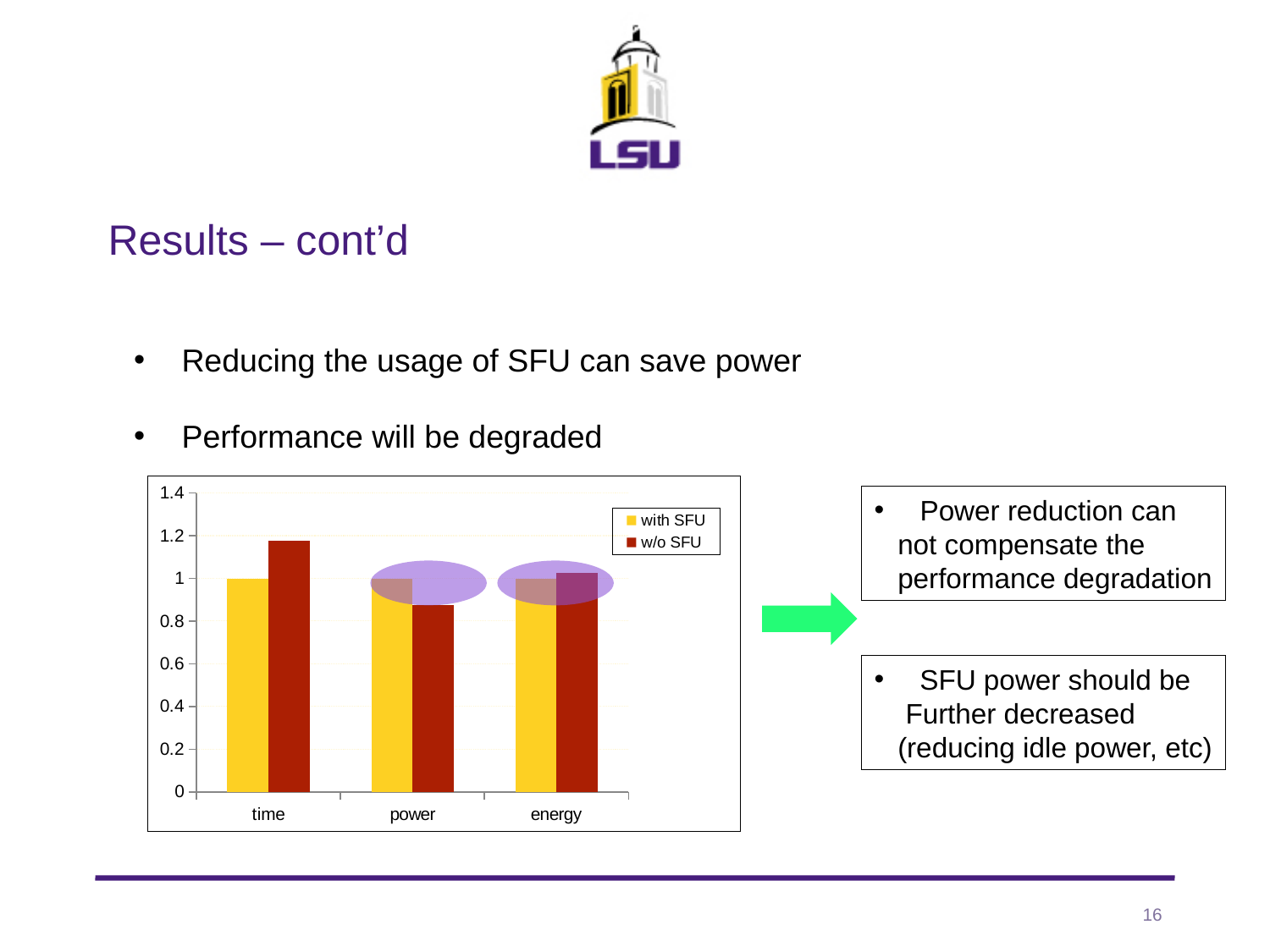
Is the 'w/o SFU' value for power greater or less than 1? less For the time category, which series has the larger value, 'with SFU' or 'w/o SFU'? w/o SFU Which category has the highest 'w/o SFU' value? time What is the value of the 'with SFU' bar for time? 1 For the power category, which series has the larger value, 'with SFU' or 'w/o SFU'? with SFU Is the 'w/o SFU' value for time greater or less than 1? greater What are the two series named in the chart's legend? with SFU and w/o SFU Which category has the lowest 'w/o SFU' value? power How many series does the chart's legend list? 2 Is the 'w/o SFU' value for power greater or less than 0.8? greater What kind of chart is shown on the slide? bar chart How many categories are shown on the x axis of the chart? 3